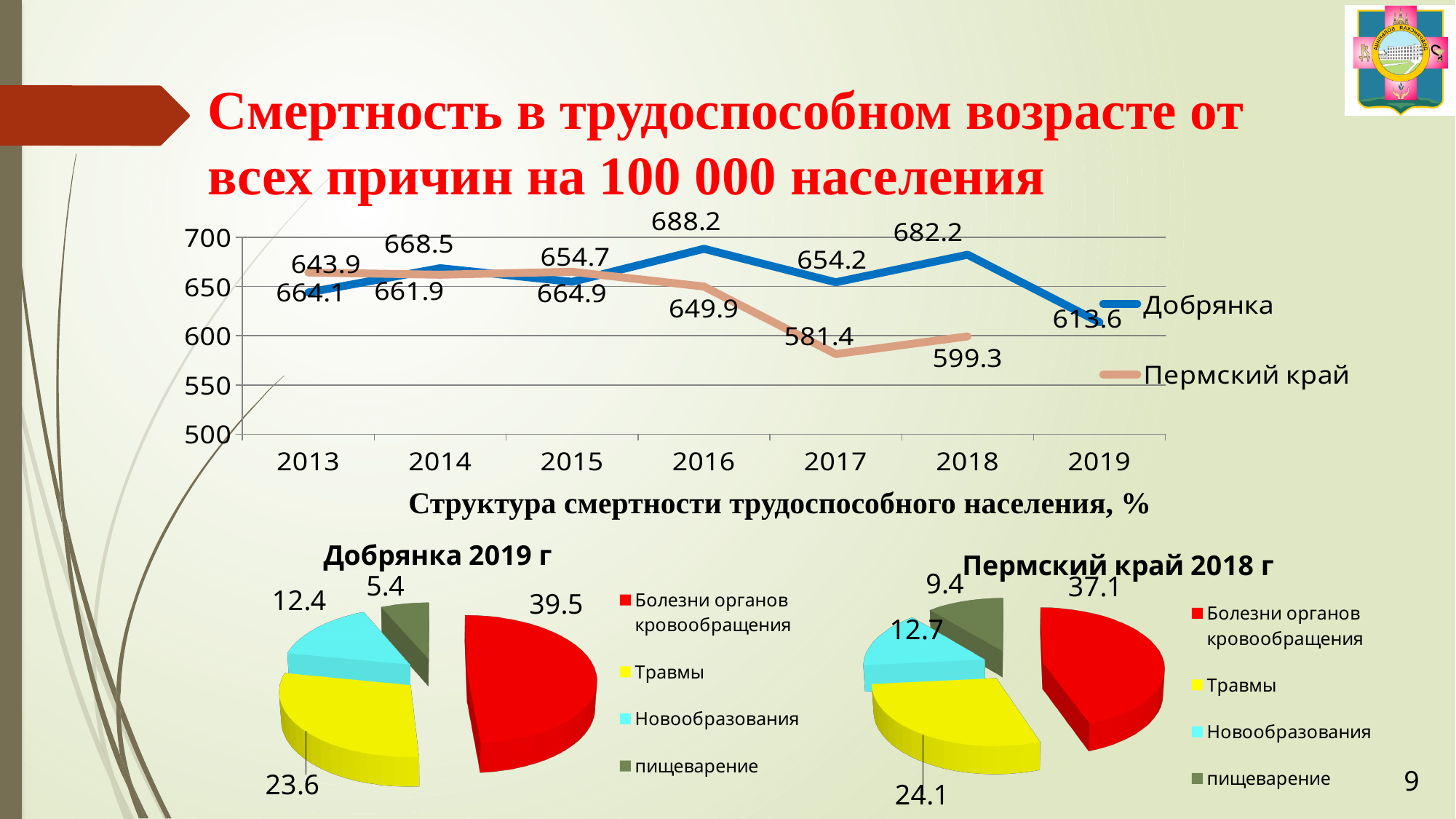
In the pie chart 'Пермский край 2018 г', what is the value for пищеварение? 9.4 In the line chart, in which year is the Добрянка value highest? 2016 How many series does the legend of the line chart list? 2 In the line chart, which series has the larger value in 2013, Добрянка or Пермский край? Пермский край What type of chart is the chart titled 'Добрянка 2019 г'? pie chart In the line chart, what is the difference between Добрянка and Пермский край in 2018? 82.9 In the pie chart 'Добрянка 2019 г', what is the value for Травмы? 23.6 In the line chart, what is the value for Пермский край in 2017? 581.4 In the line chart, what is the value for Добрянка in 2016? 688.2 In the pie chart 'Пермский край 2018 г', which category has the largest slice? Болезни органов кровообращения In the line chart, in which year is the Пермский край value lowest? 2017 In the line chart, what is the value for Добрянка in 2019? 613.6